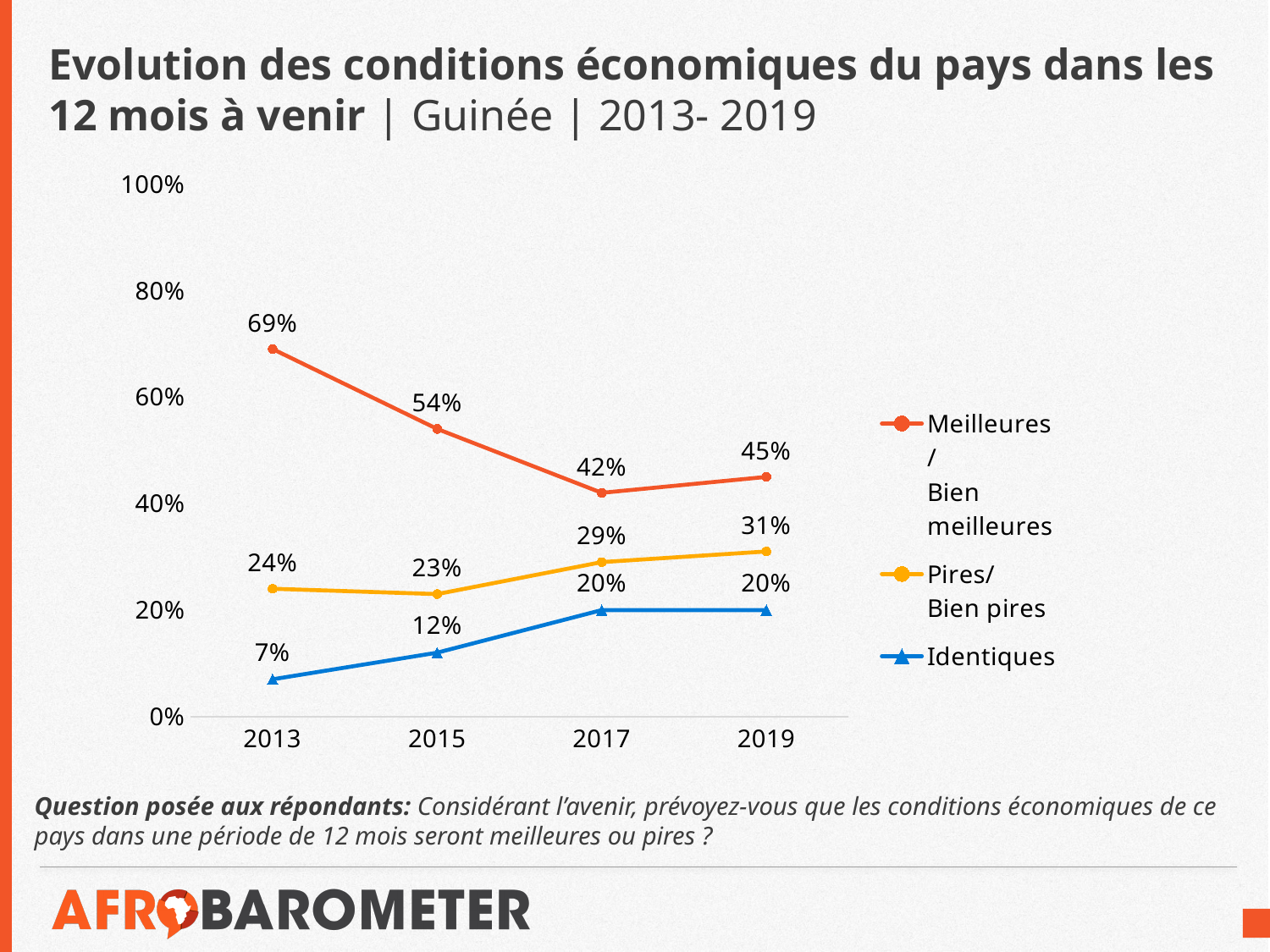
What percentage of respondents expected conditions to be 'Meilleures / Bien meilleures' in 2013? 69% What is the value for 'Pires/ Bien pires' in 2019? 31% What kind of chart is shown on the slide? Line chart In which year was the 'Identiques' series at its lowest? 2013 Which series had the higher value in 2017: 'Pires/ Bien pires' or 'Identiques'? Pires/ Bien pires In which year was the 'Meilleures / Bien meilleures' series at its lowest? 2017 How many years are shown on the x axis? 4 What is the difference between 'Pires/ Bien pires' and 'Identiques' in 2019? 11 percentage points How many series does the legend list? 3 Does the 'Pires/ Bien pires' series rise or fall between 2015 and 2019? Rise What is the difference between the 'Meilleures / Bien meilleures' values in 2013 and 2015? 15 percentage points What is the value for 'Identiques' in 2015? 12%